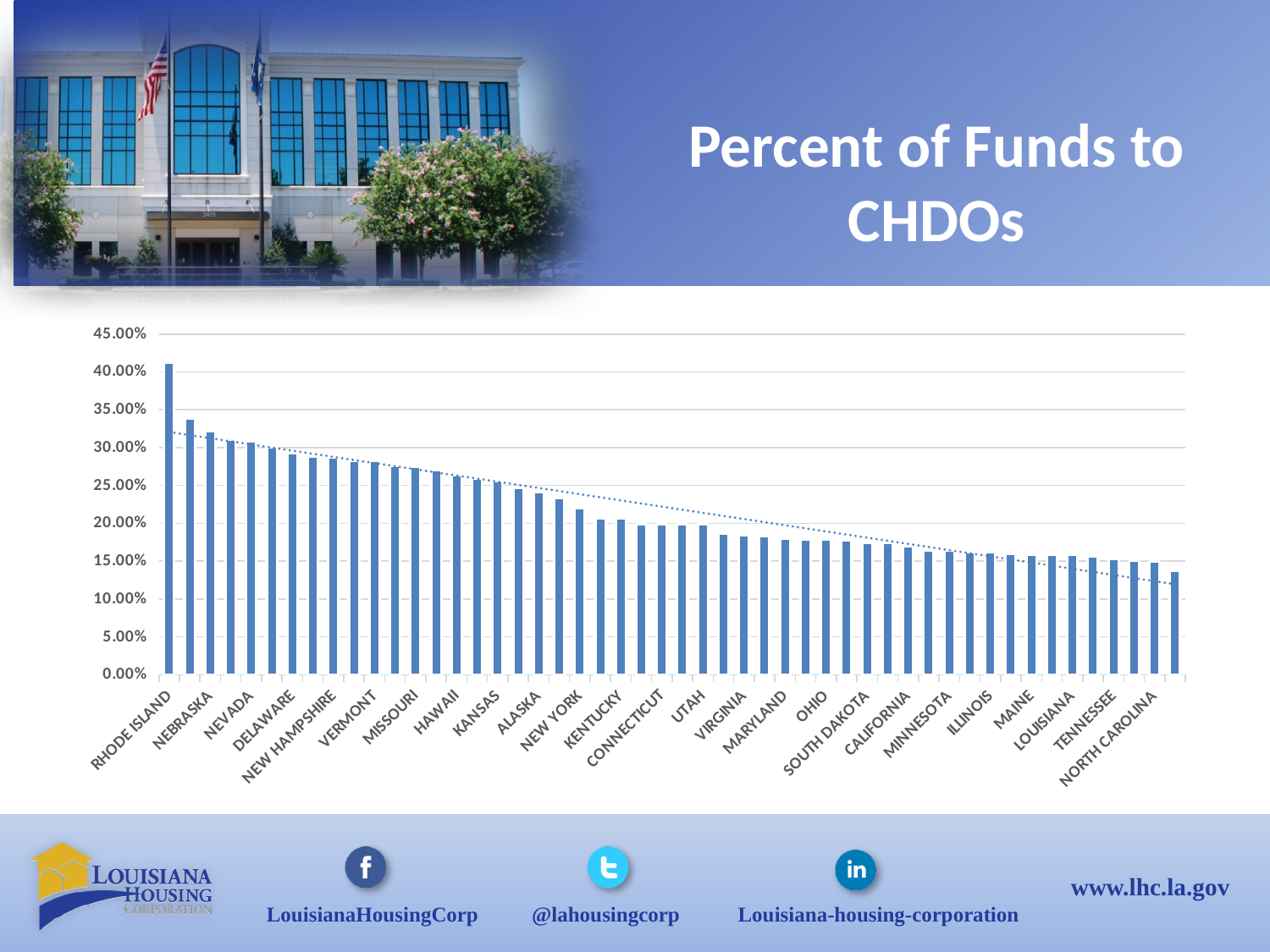
What is the highest value shown on the y axis? 45.00% Is the value for North Carolina greater or less than 20.00%? less Which is larger, the value for Rhode Island or the value for North Carolina? Rhode Island What kind of chart is shown on the slide? bar chart Is the value for Louisiana greater or less than 20.00%? less What is the title of the chart? Percent of Funds to CHDOs Is the value for Rhode Island greater or less than 35.00%? greater Do the values rise or fall moving from left to right along the x axis? fall Which is larger, the value for Nevada or the value for Ohio? Nevada Which state has the highest percent of funds to CHDOs? Rhode Island